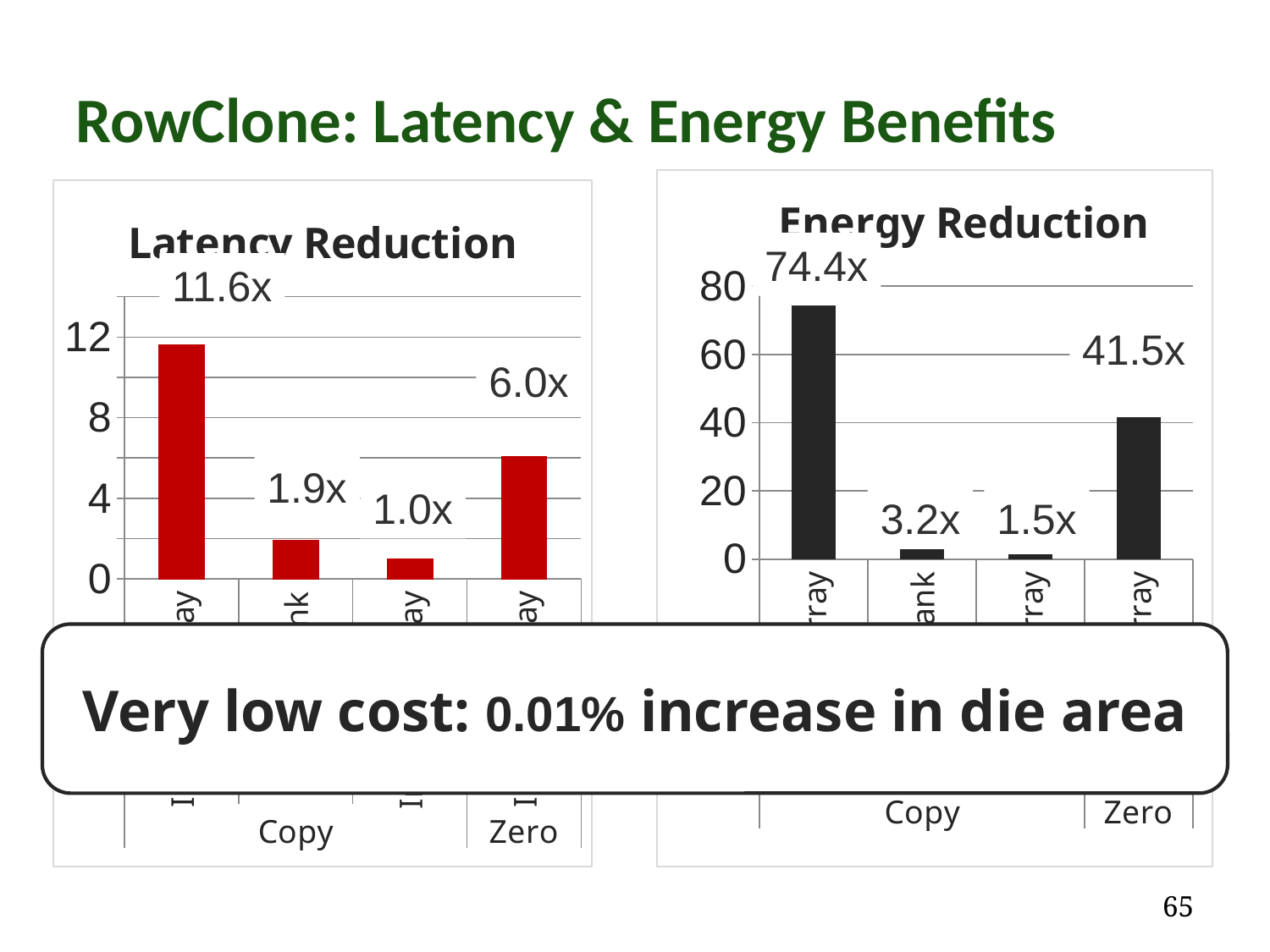
On the Latency Reduction chart, what is the value of the bar in the Zero group? 6.0x On the Energy Reduction chart, what is the highest value shown? 74.4x On the Latency Reduction chart, what is the highest value shown? 11.6x On the Energy Reduction chart, what is the difference between the highest value (74.4x) and the Zero bar (41.5x)? 32.9x On the Energy Reduction chart, is the tallest bar greater or less than 60? greater What kind of chart is the Energy Reduction chart? Bar chart How many bars are plotted on the Latency Reduction chart? 4 On the Latency Reduction chart, what is the difference between the highest value (11.6x) and the Zero bar (6.0x)? 5.6x What colour are the bars on the Latency Reduction chart? Red On the Energy Reduction chart, what is the value of the bar in the Zero group? 41.5x On the Latency Reduction chart, what is the lowest value shown? 1.0x On the Energy Reduction chart, what is the lowest value shown? 1.5x